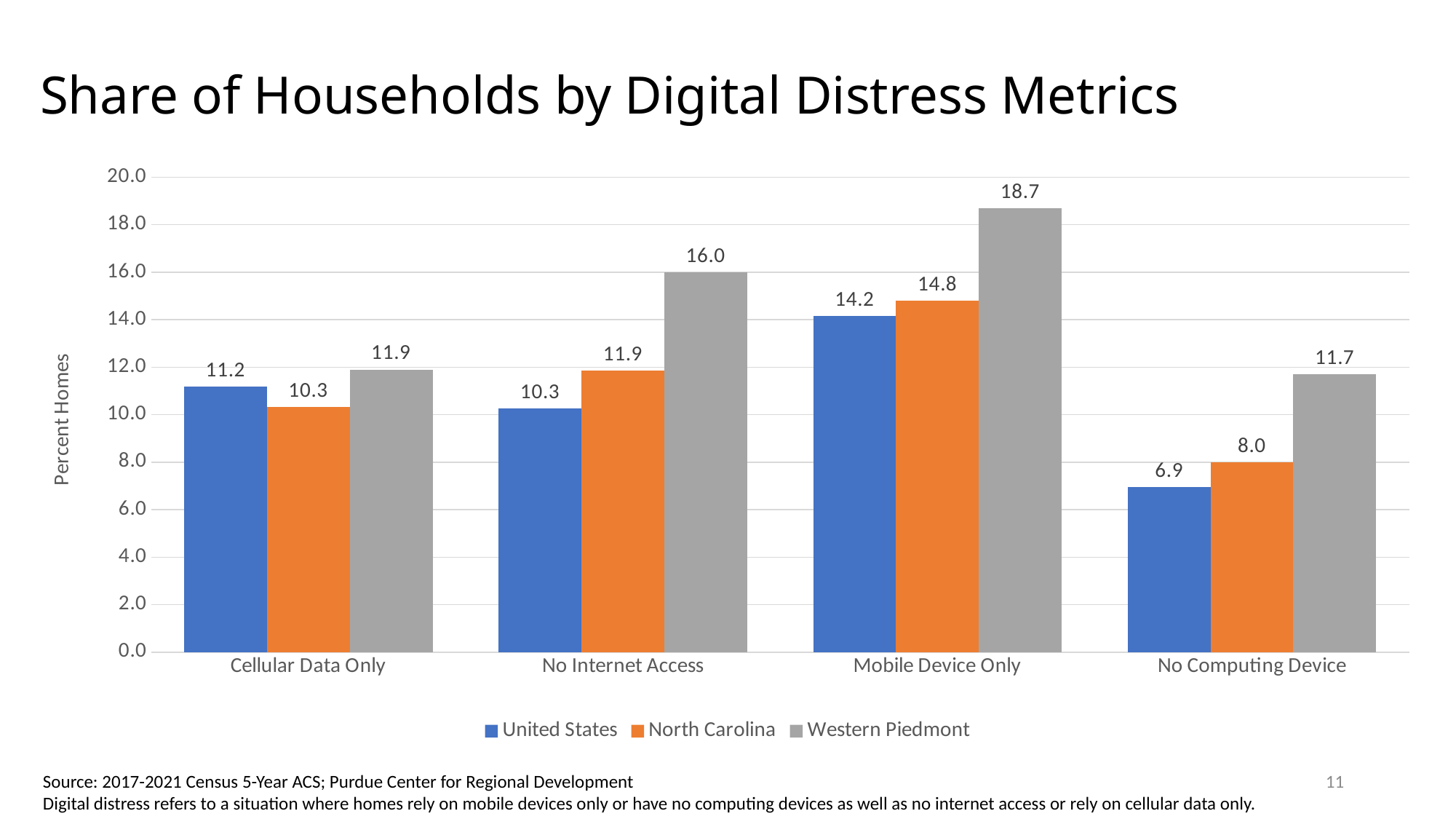
What is the value for North Carolina in the No Internet Access category? 11.9 What is the label of the y axis? Percent Homes What kind of chart is shown on the slide? Bar chart What is the value for United States in the No Computing Device category? 6.9 What is the difference between Western Piedmont and United States in the No Internet Access category? 5.7 Which category has the highest value for Western Piedmont? Mobile Device Only Is the value for Western Piedmont in the No Computing Device category greater or less than 10.0? greater How many series does the legend list? 3 How many categories are shown on the x axis? 4 Which is larger in the Cellular Data Only category: United States or North Carolina? United States Which category has the lowest value for United States? No Computing Device What is the value for Western Piedmont in the Mobile Device Only category? 18.7